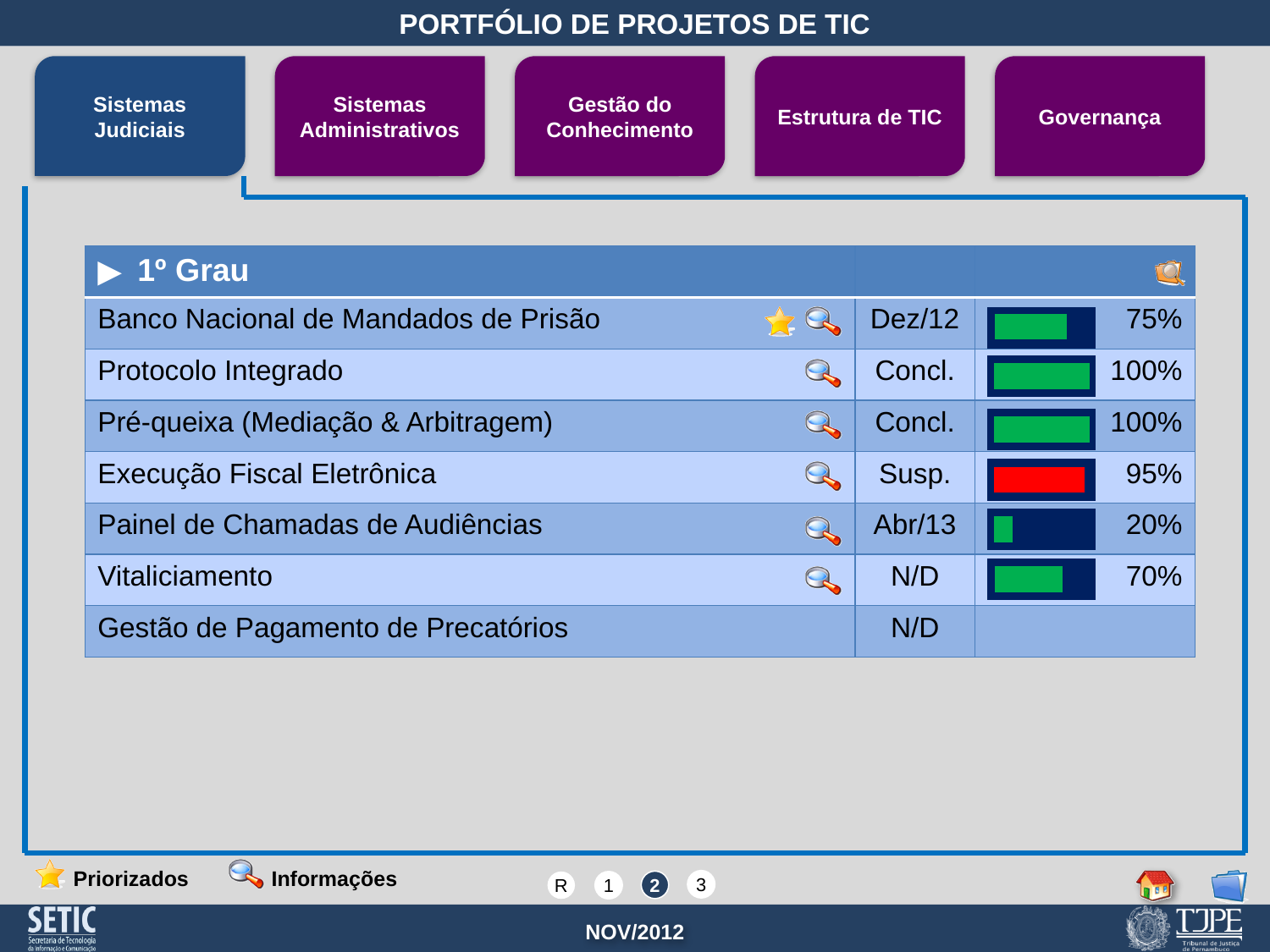
How many projects in the 1º Grau table show a progress bar? 6 What progress percentage is shown for Banco Nacional de Mandados de Prisão? 75% What is the difference in progress between Execução Fiscal Eletrônica and Vitaliciamento? 25% Which project has the lowest progress percentage in the 1º Grau table? Painel de Chamadas de Audiências Which project's progress bar is coloured red instead of green? Execução Fiscal Eletrônica Which has a higher progress percentage, Vitaliciamento or Banco Nacional de Mandados de Prisão? Banco Nacional de Mandados de Prisão What progress percentage is shown for Vitaliciamento? 70% How many projects are listed in the 1º Grau table? 7 What progress percentage is shown for Painel de Chamadas de Audiências? 20% What is the difference in progress between Banco Nacional de Mandados de Prisão and Painel de Chamadas de Audiências? 55% What progress percentage is shown for Execução Fiscal Eletrônica? 95% What is the status shown for Execução Fiscal Eletrônica? Susp.